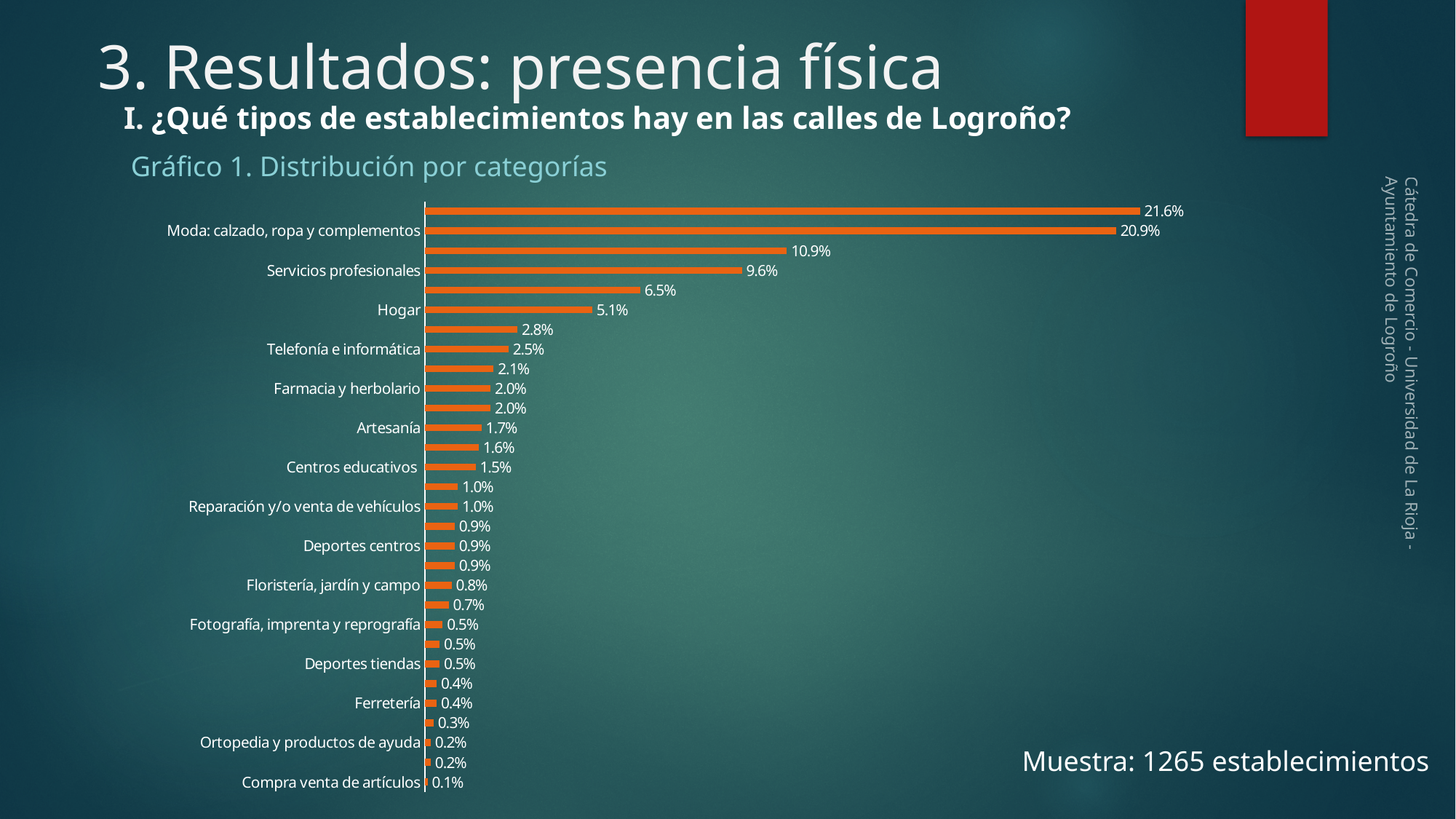
Which is larger, the value for Hogar or the value for Telefonía e informática? Hogar What is the difference between the values for Moda: calzado, ropa y complementos and Servicios profesionales? 11.3 percentage points What is the value for Ferretería? 0.4% Which labelled category has the lowest value? Compra venta de artículos What is the title of the chart? Gráfico 1. Distribución por categorías What is the highest value shown on the chart? 21.6% What is the value for Hogar? 5.1% Do the values increase or decrease going from the top bar to the bottom bar? Decrease What kind of chart is shown on the slide? Bar chart What is the value for Moda: calzado, ropa y complementos? 20.9% What is the value for Servicios profesionales? 9.6% How many bars are plotted on the chart? 30